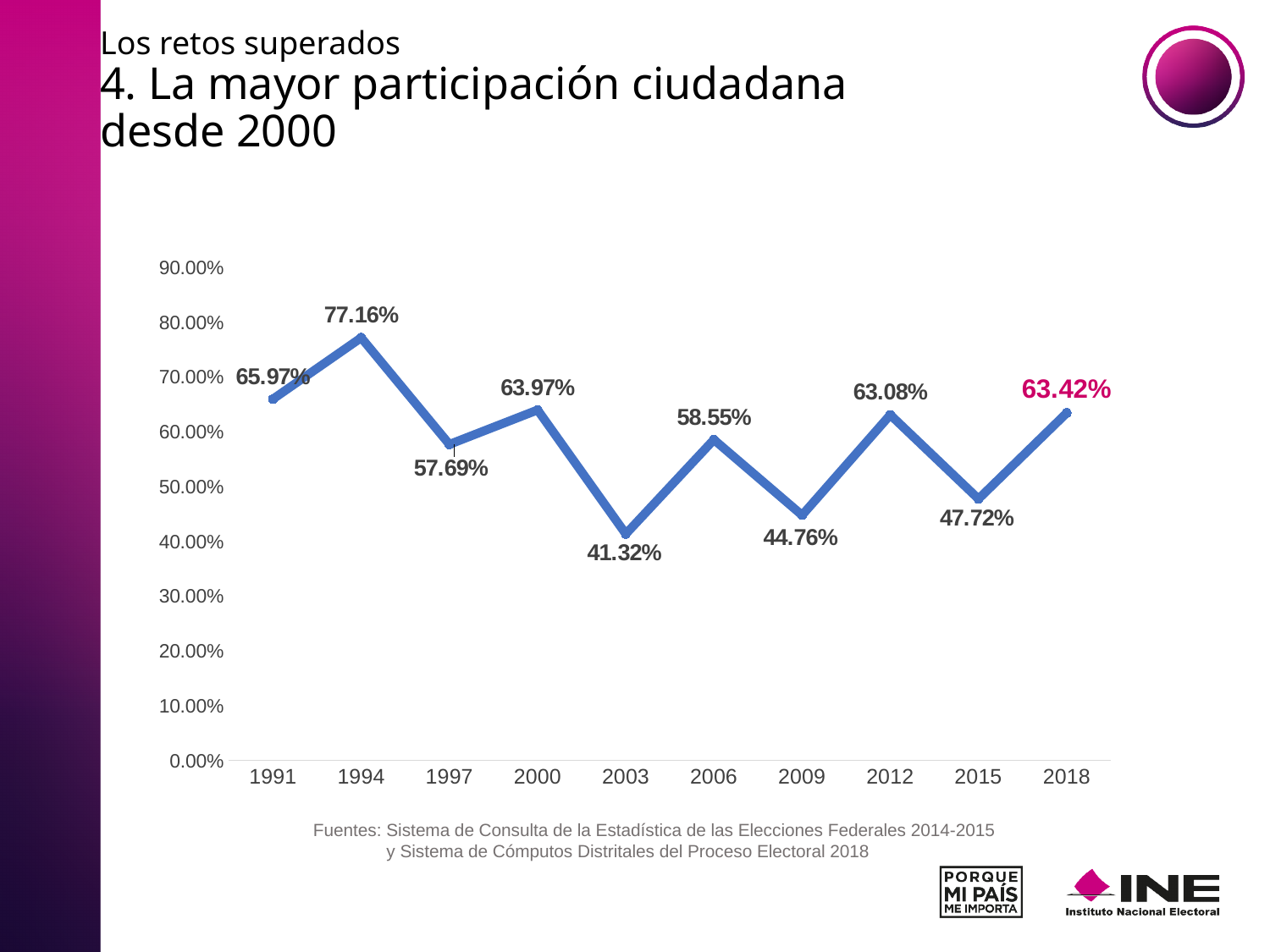
What kind of chart is shown on the slide? line chart Is the value for 2000 greater or less than 60.00%? greater What is the difference between the 2018 value and the 2015 value? 15.70% How many years are plotted on the x axis? 10 What was the participation rate in 2018? 63.42% Did the participation rate rise or fall from 2015 to 2018? rise Which year has the highest participation rate? 1994 Which year has the lowest participation rate? 2003 Which is larger, the value for 2006 or the value for 2009? 2006 What is the difference between the highest value (1994) and the lowest value (2003)? 35.84% What value is shown for 2003? 41.32% What was the participation rate in 1994? 77.16%